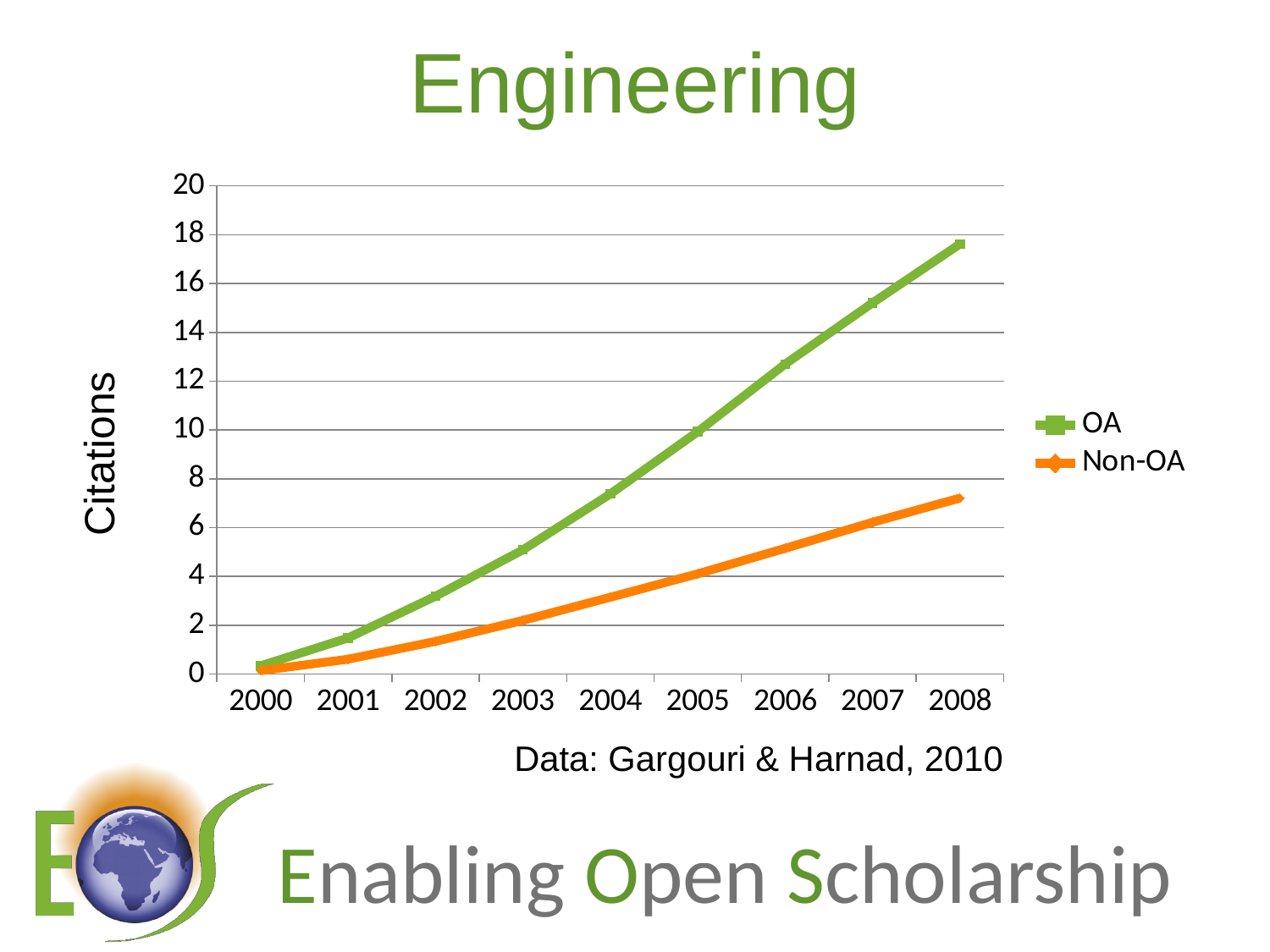
Do the OA citations rise or fall from 2000 to 2008? rise In which year is the Non-OA series at its lowest? 2000 How many years are plotted along the x axis? 9 Is the Non-OA value for 2004 greater or less than 4? less In which year is the OA series at its highest? 2008 Is the Non-OA value for 2008 greater or less than 8? less Is the OA value for 2004 greater or less than 6? greater How many series does the legend list? 2 What kind of chart is shown on the slide? line chart In 2008, which series has more citations, OA or Non-OA? OA What is the label on the vertical axis of the chart? Citations